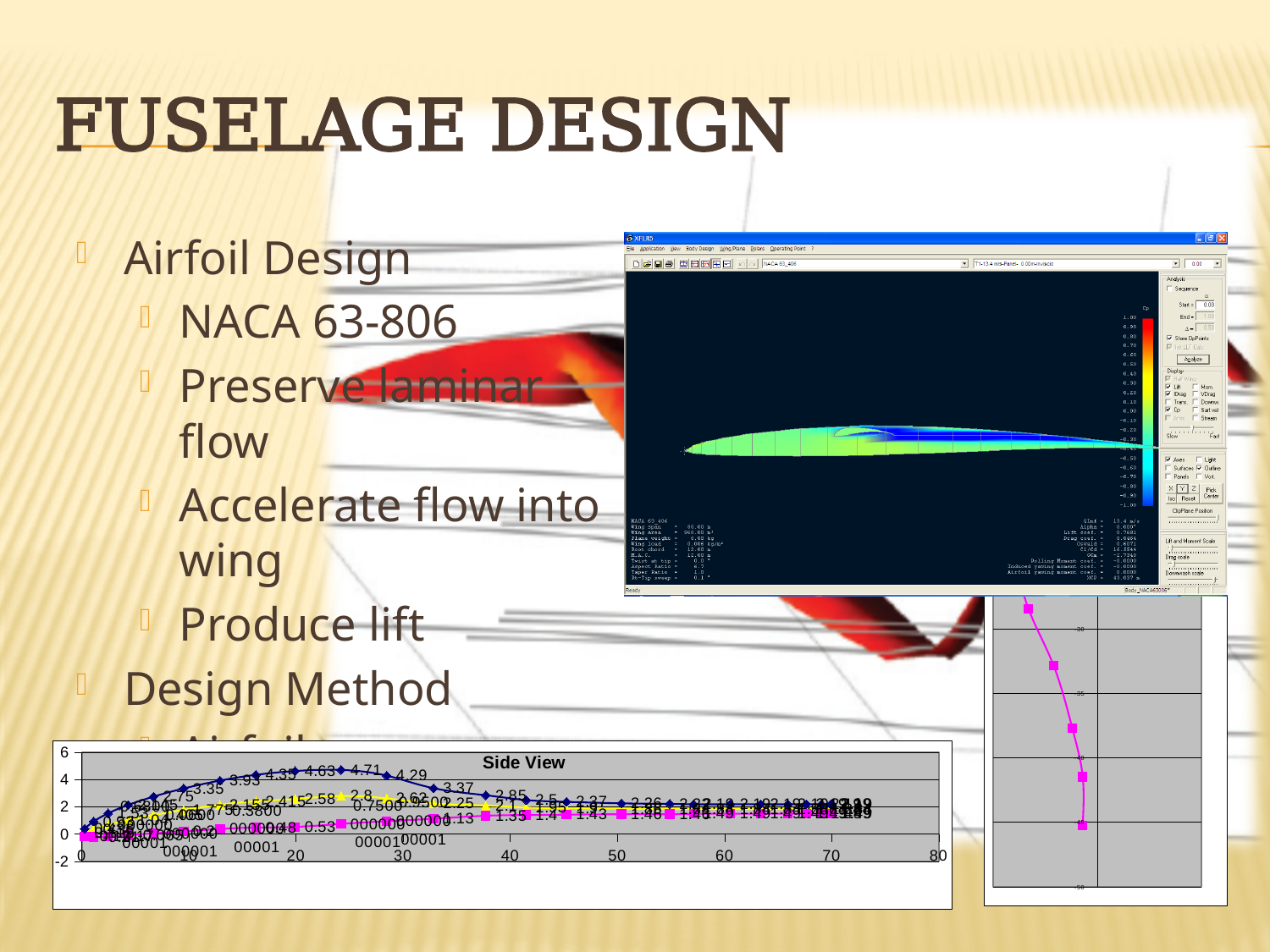
In the "Side View" chart, is the value of the upper (blue) series at x = 60 greater or less than 4? less What kind of chart is the small chart on the right side of the slide, below the software screenshot? line chart In the "Side View" chart, does the upper (blue) series rise or fall as x increases from 30 to 80? fall What is the largest value shown on the x axis of the "Side View" chart? 80 In the "Side View" chart, what is the highest labelled value on the upper (blue) series? 4.71 In the "Side View" chart, is the peak value of the upper (blue) series greater or less than 4? greater What is the title of the chart at the bottom of the slide? Side View In the "Side View" chart, is the value of the lower (magenta) series at x = 50 greater or less than 2? less What kind of chart is the "Side View" chart at the bottom of the slide? line chart